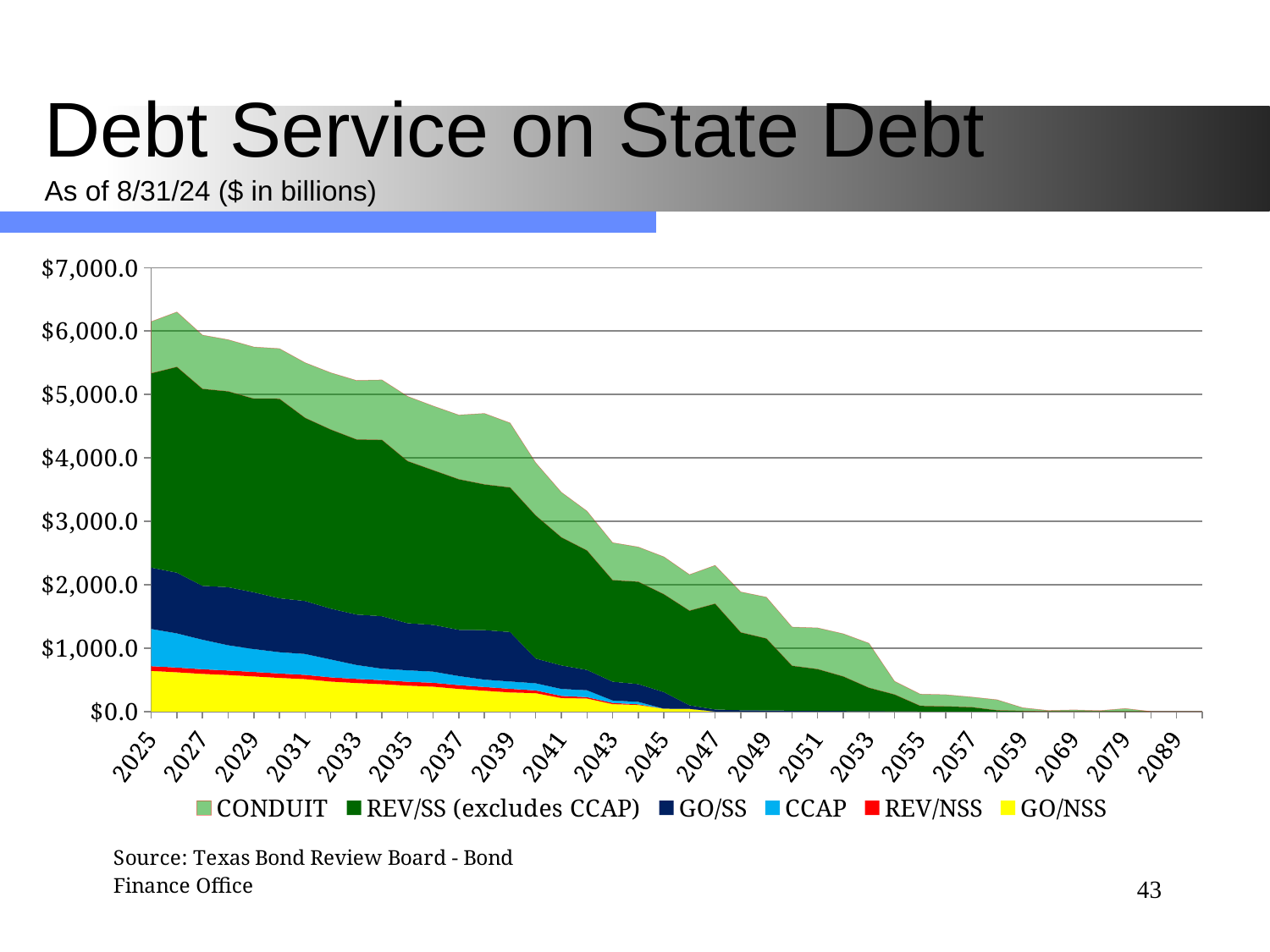
Is the total debt service for 2045 greater or less than $3,000.0? less How many year labels are shown on the x axis? 21 How many series does the legend list? 6 Is the total debt service for 2035 greater or less than $3,000.0? greater What colour represents GO/NSS in the chart? Yellow Is the total debt service for 2055 greater or less than $1,000.0? less Do the total debt service values rise or fall as the years move from 2025 toward 2089? Fall What kind of chart is shown on the slide? Stacked area chart In 2025, which is larger: GO/NSS or REV/NSS? GO/NSS Which series contributes the largest amount of debt service in 2025? REV/SS (excludes CCAP) What is the title of the chart slide? Debt Service on State Debt